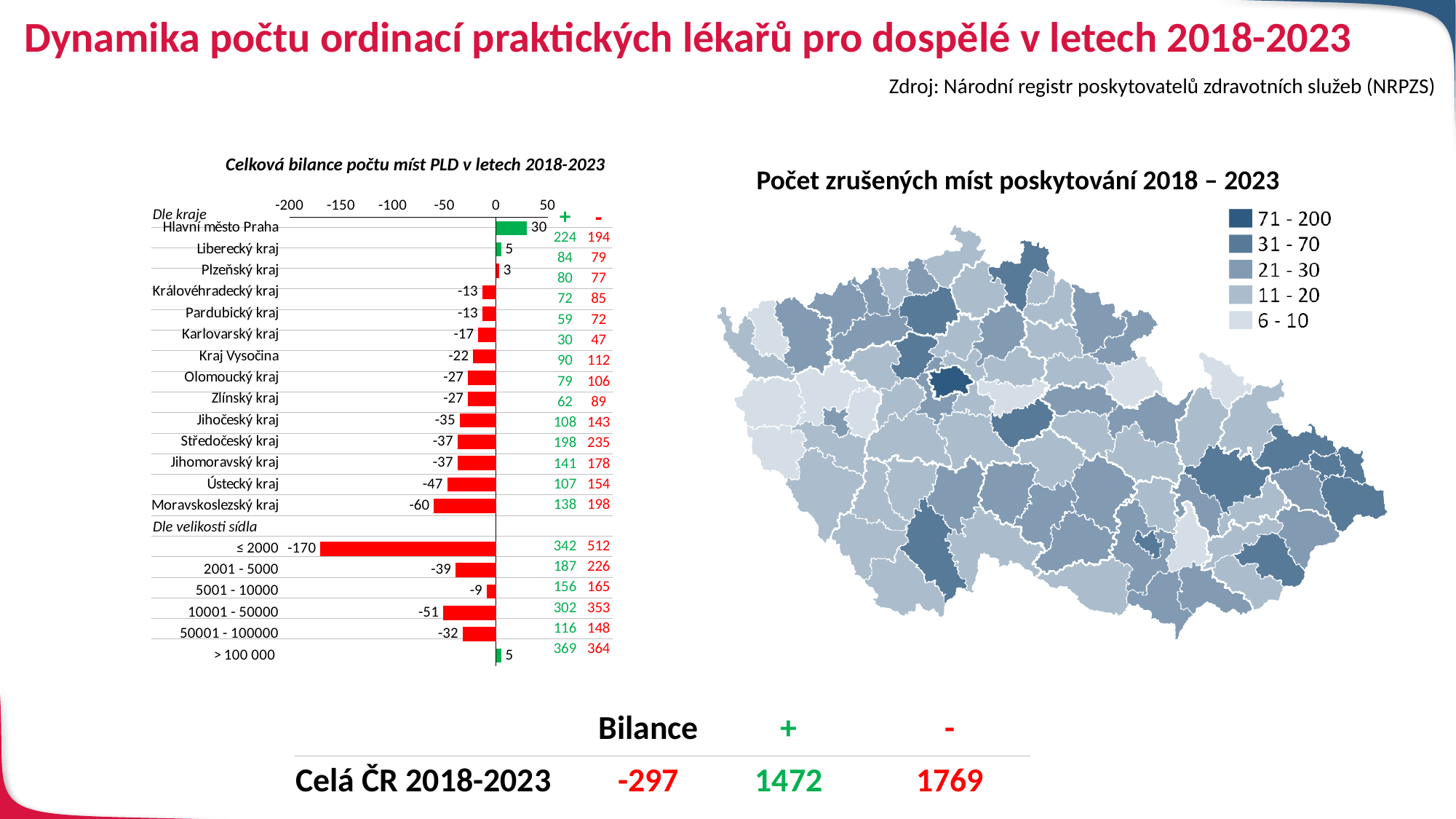
In the chart 'Celková bilance počtu míst PLD v letech 2018-2023', which region (Dle kraje) has the lowest value? Moravskoslezský kraj In the chart 'Celková bilance počtu míst PLD v letech 2018-2023', which has the larger value, Jihočeský kraj or Kraj Vysočina? Kraj Vysočina In the chart 'Celková bilance počtu míst PLD v letech 2018-2023', what is the difference between the values for Ústecký kraj and Moravskoslezský kraj? 13 In the chart 'Celková bilance počtu míst PLD v letech 2018-2023', what is the value for Hlavní město Praha? 30 How many regions (Dle kraje) are plotted in the chart 'Celková bilance počtu míst PLD v letech 2018-2023'? 14 In the chart 'Celková bilance počtu míst PLD v letech 2018-2023', is the value for the category ≤ 2000 greater or less than -150? less How many settlement size categories (Dle velikosti sídla) are plotted in the chart 'Celková bilance počtu míst PLD v letech 2018-2023'? 6 In the chart 'Celková bilance počtu míst PLD v letech 2018-2023', what colour are the bars with negative values? red What kind of chart is 'Celková bilance počtu míst PLD v letech 2018-2023'? bar chart In the chart 'Celková bilance počtu míst PLD v letech 2018-2023', what is the value for the settlement size category ≤ 2000? -170 In the chart 'Celková bilance počtu míst PLD v letech 2018-2023', what is the value for Moravskoslezský kraj? -60 In the chart 'Celková bilance počtu míst PLD v letech 2018-2023', which region (Dle kraje) has the highest value? Hlavní město Praha